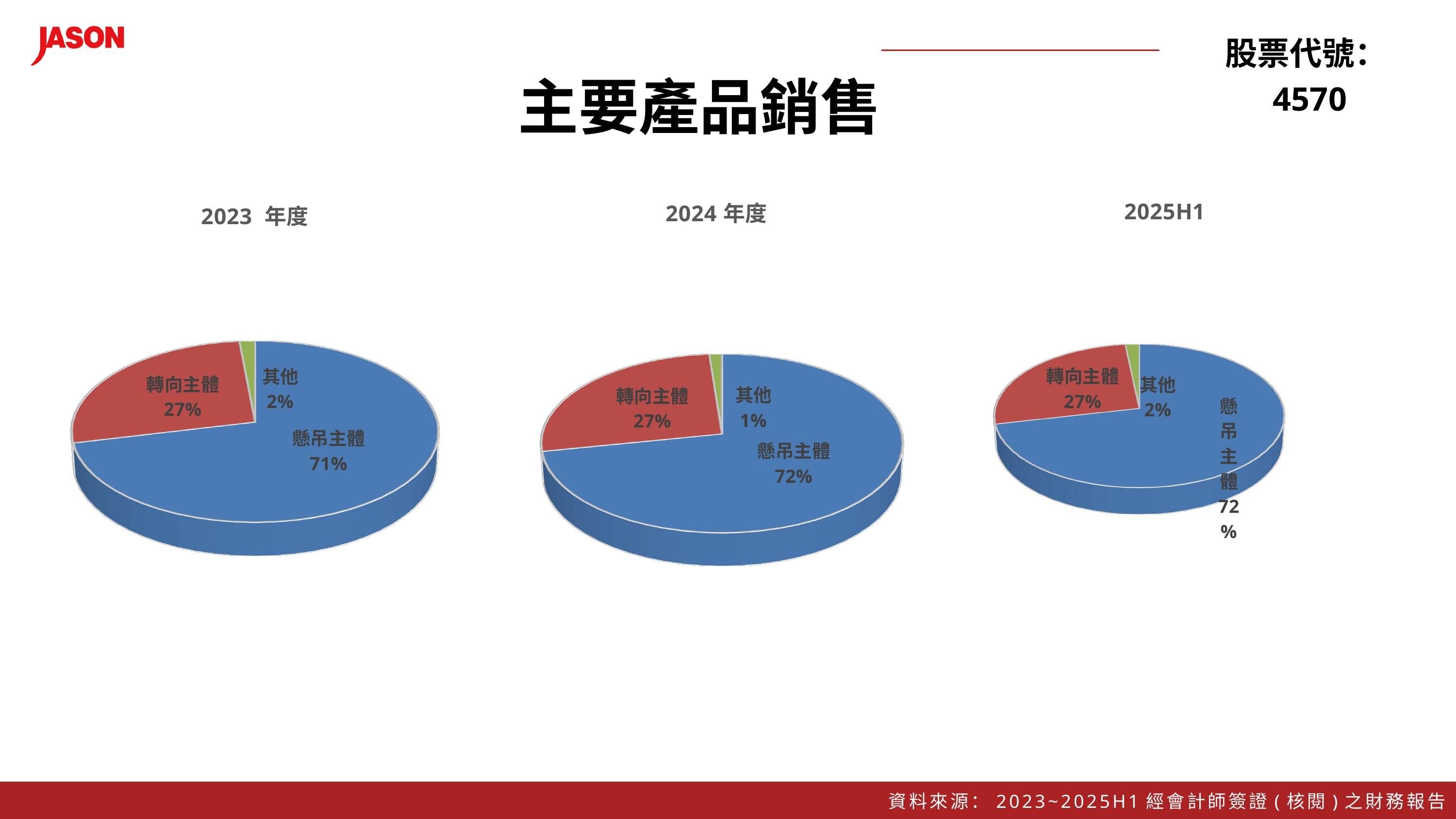
In the 2023 年度 pie chart, what colour is the 轉向主體 slice? Red In the 2023 年度 pie chart, which category has the largest share? 懸吊主體 In the 2024 年度 pie chart, what share does 其他 have? 1% How many slices does the 2025H1 pie chart have? 3 In the 2025H1 pie chart, what share does 懸吊主體 have? 72% How many pie charts are shown on the slide? 3 In the 2024 年度 pie chart, which category has the smallest share? 其他 In the 2024 年度 pie chart, which is larger, the share of 轉向主體 or the share of 其他? 轉向主體 In the 2025H1 pie chart, what share does 轉向主體 have? 27% In the 2023 年度 pie chart, what share does 懸吊主體 have? 71% What kind of chart is used for 2024 年度? Pie chart In the 2023 年度 pie chart, what is the difference between the shares of 懸吊主體 and 轉向主體? 44%